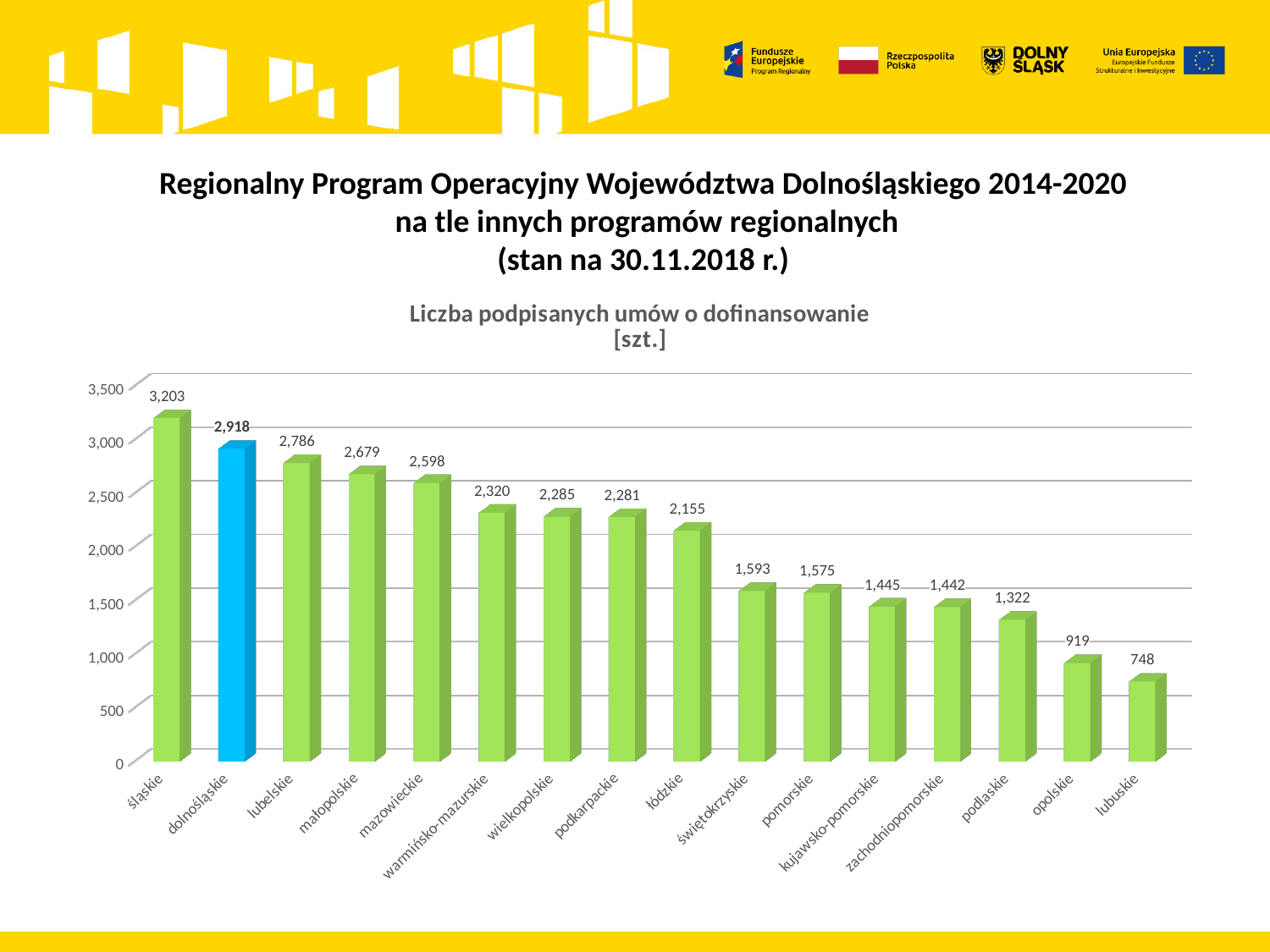
What is the value for lubuskie? 748 What is the value for dolnośląskie? 2,918 What is the difference between the values for śląskie and dolnośląskie? 285 Which category has the lowest value? lubuskie Do the values rise or fall from left to right along the x axis? fall Which bar is shown in a different colour (blue) from the others? dolnośląskie Which is larger, the value for pomorskie or the value for podlaskie? pomorskie Which category has the highest value? śląskie Is the value for opolskie greater or less than 1,000? less How many categories are shown on the x axis? 16 What kind of chart is this? bar chart What is the value for warmińsko-mazurskie? 2,320